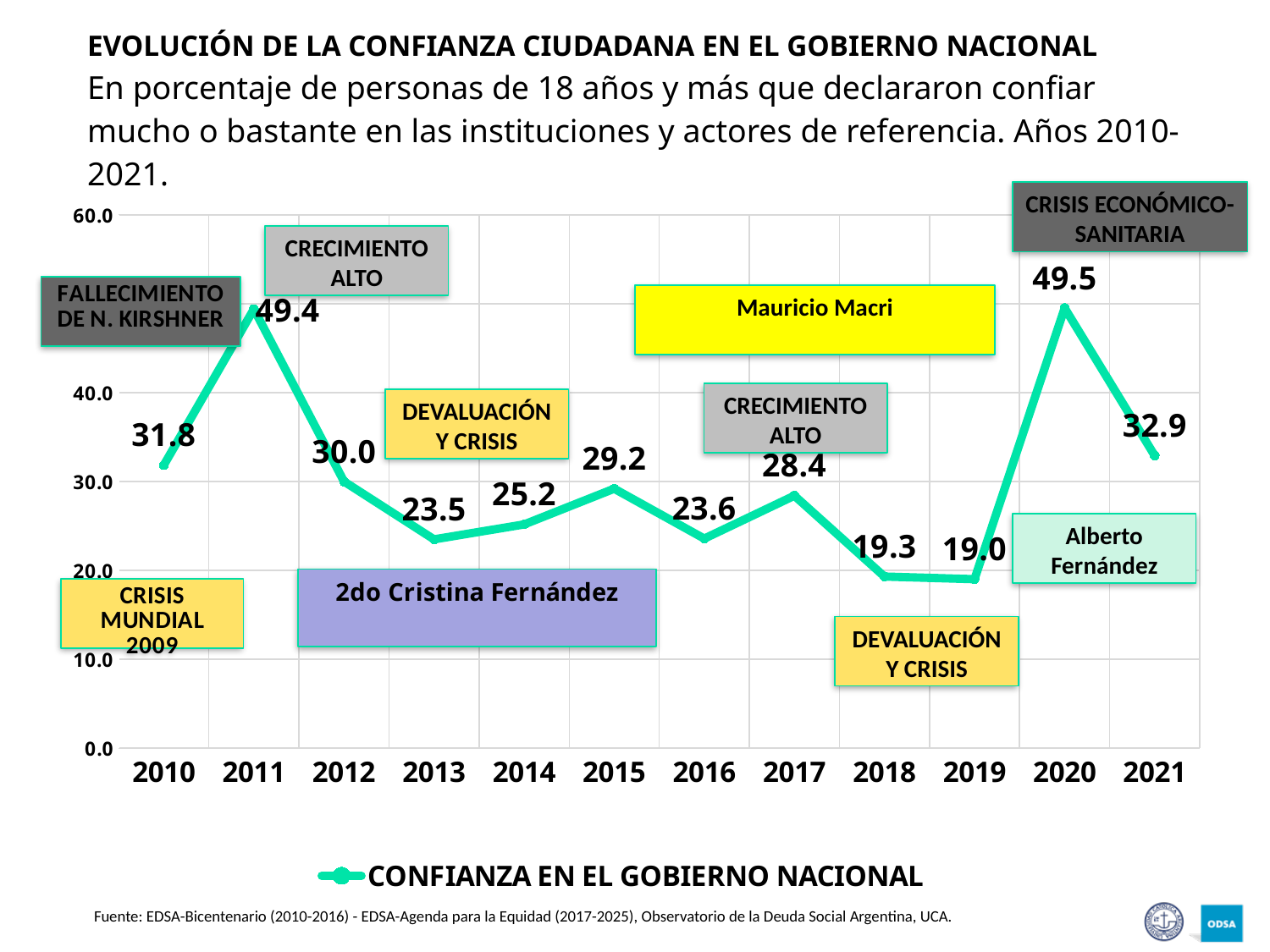
What is the value for 2021? 32.9 How many series does the legend list? 1 What is the value for 2011? 49.4 What is the value for 2013? 23.5 What is the difference between the values for 2020 and 2019? 30.5 What is the value for 2020? 49.5 What kind of chart is shown? line chart Do the values rise or fall from 2017 to 2019? fall Which is larger, the value for 2015 or the value for 2016? 2015 Is the value for 2018 greater or less than 20.0? less How many years are plotted on the x axis? 12 What is the difference between the values for 2011 and 2012? 19.4